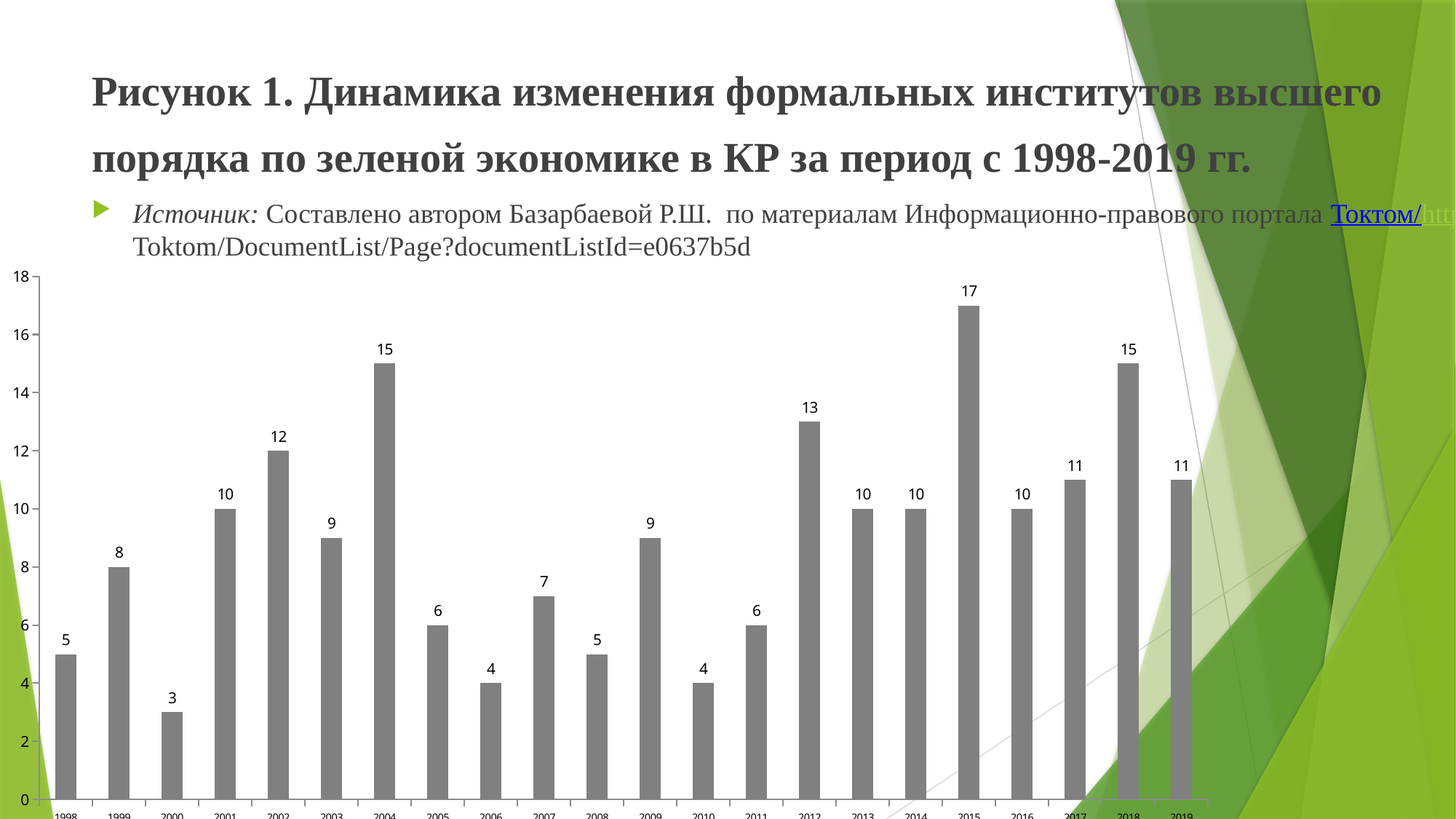
Is the value for 2009 greater or less than 10? less What is the difference between the values for 2004 and 2005? 9 What is the value for 2012? 13 What is the value for 2000? 3 What is the value for 2015? 17 How many years are shown on the x axis? 22 What is the difference between the values for 2015 and 2018? 2 What is the value for 2019? 11 Which year has the lowest value? 2000 Which year has the highest value? 2015 What kind of chart is shown on the slide? Bar chart Which is larger, the value for 2002 or the value for 2003? 2002